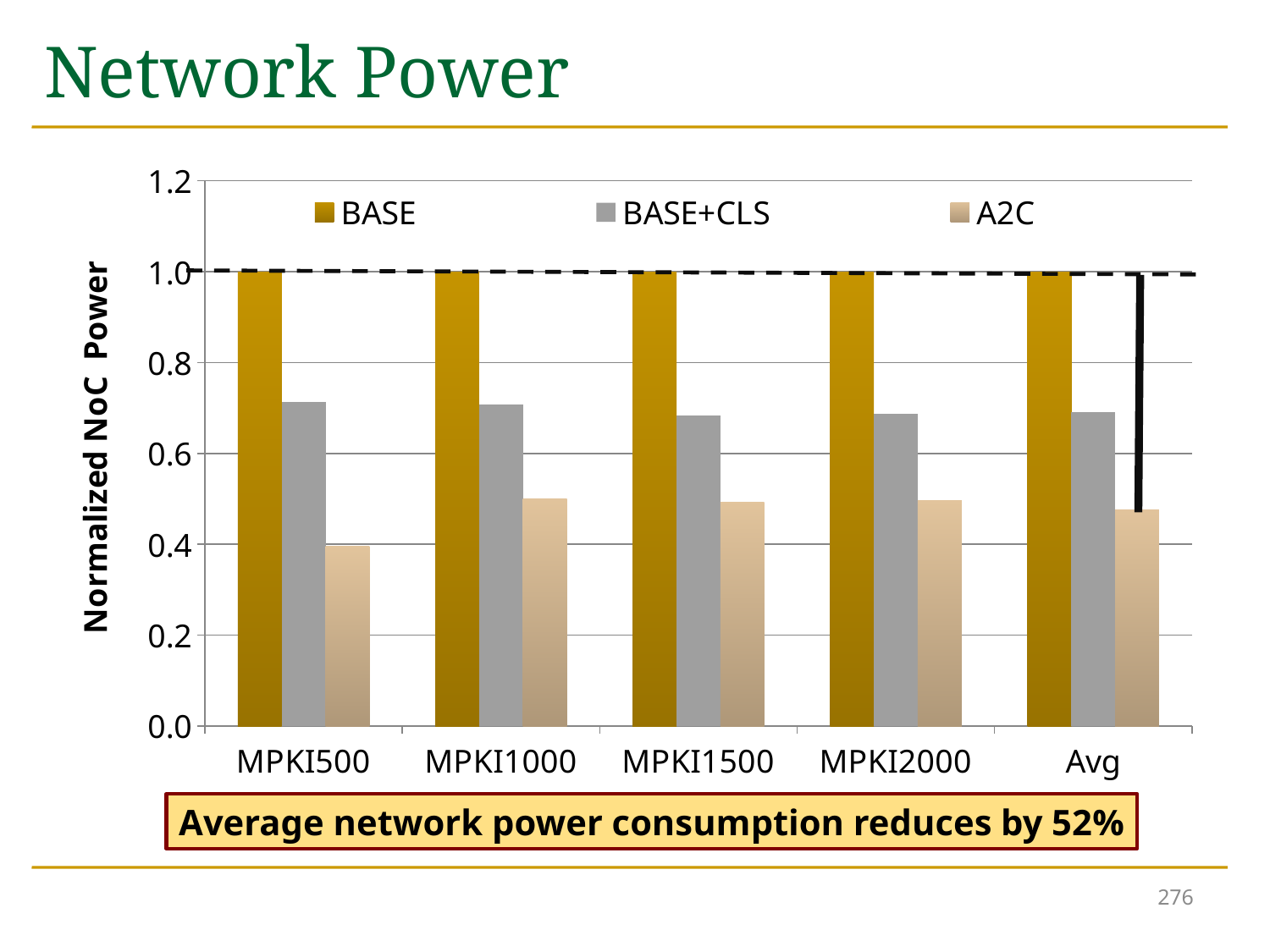
How many categories are shown on the x axis? 5 What is the value of BASE for Avg? 1.0 Is the value of BASE+CLS for MPKI500 greater or less than 0.6? greater Is the value of A2C for Avg greater or less than 0.6? less What kind of chart is shown on the slide? bar chart Is the value of BASE+CLS for MPKI1500 greater or less than 0.8? less For MPKI2000, which is larger: BASE+CLS or A2C? BASE+CLS What is the value of BASE for MPKI500? 1.0 What is the label of the y axis? Normalized NoC Power For which category is the A2C value lowest? MPKI500 How many series does the legend list? 3